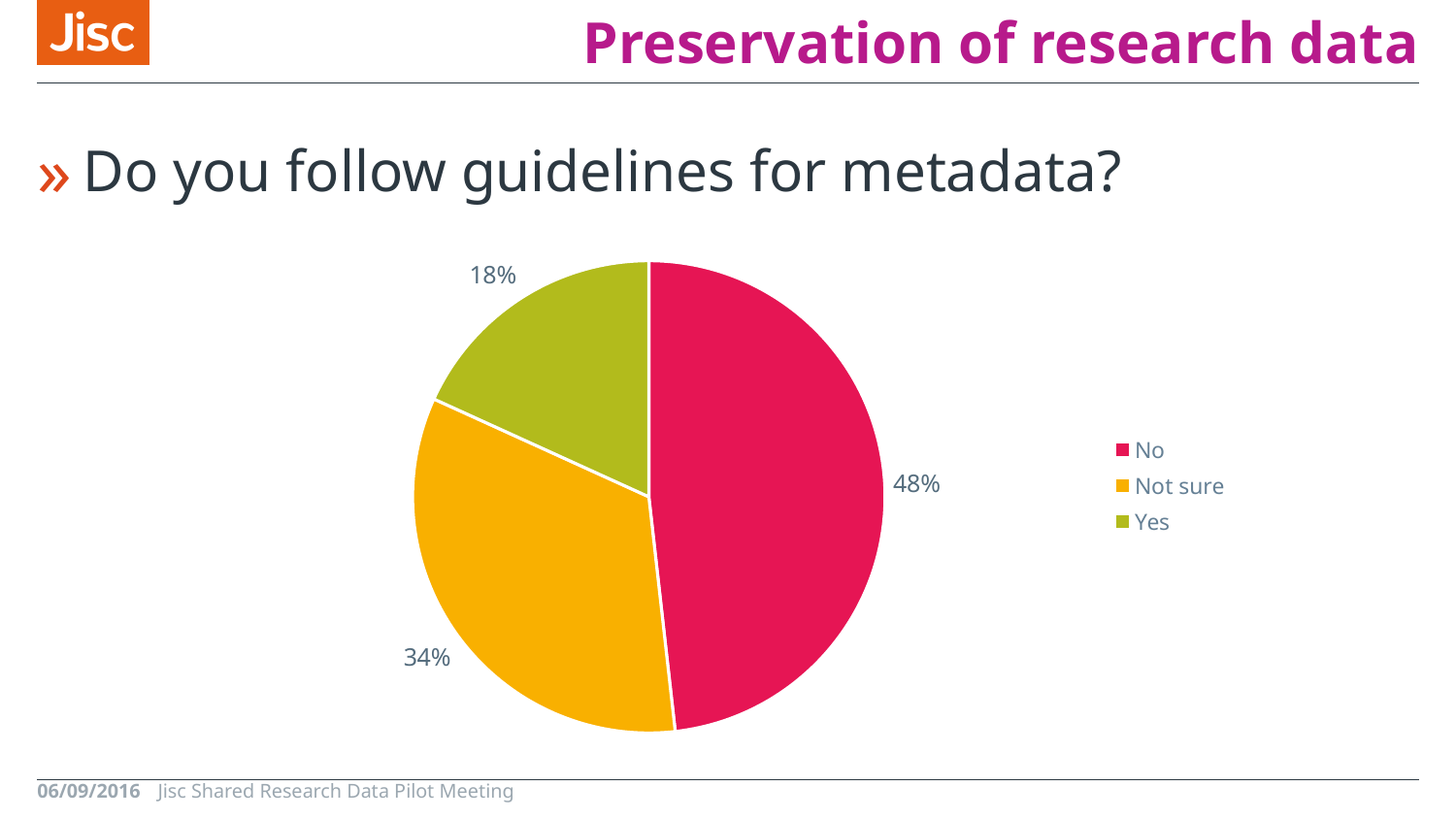
Which is larger, the share for "Not sure" or the share for "Yes"? Not sure What kind of chart is shown on the slide? Pie chart What percentage of respondents answered "No" to following guidelines for metadata? 48% What is the difference in percentage points between the "No" and "Yes" responses? 30 How many slices does the pie chart have? 3 Which response has the smallest share of the pie? Yes What percentage of respondents answered "Yes"? 18% What is the difference in percentage points between the "Not sure" and "Yes" responses? 16 Which response has the largest share of the pie? No What percentage of respondents answered "Not sure"? 34% How many entries does the legend list? 3 What colour is the "Not sure" slice? Yellow/orange